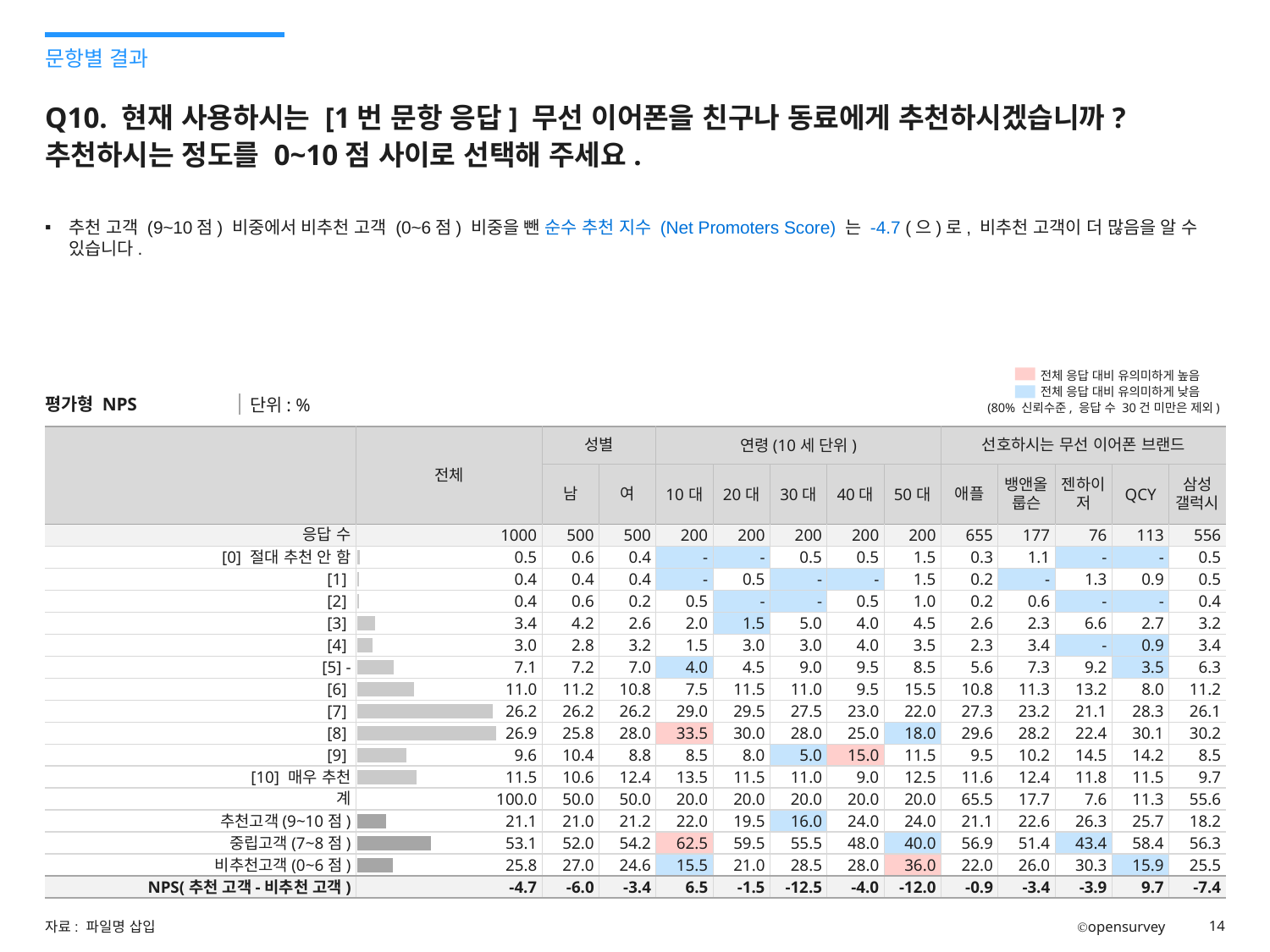
Among 추천고객, 중립고객 and 비추천고객 in the 전체 column, which group has the lowest value? 추천고객 (9~10 점) In the 전체 column, what is the difference between 비추천고객 (0~6 점) and 추천고객 (9~10 점)? 4.7 In the 전체 column, what is the value for [10] 매우 추천? 11.5 What kind of chart is embedded in the 전체 column of the table? Bar chart In the 전체 column, which is larger, the value for [6] or the value for [9]? [6] How many score categories from [0] to [10] are shown in the table? 11 What unit is stated for the values in the table? % What is the total of 추천고객, 중립고객 and 비추천고객 in the 전체 column? 100.0 What is the NPS (추천 고객 - 비추천 고객) value for 전체? -4.7 In the 전체 column, what is the value for [7]? 26.2 In the 전체 column, what is the value for 중립고객 (7~8 점)? 53.1 Among 추천고객, 중립고객 and 비추천고객 in the 전체 column, which group has the highest value? 중립고객 (7~8 점)